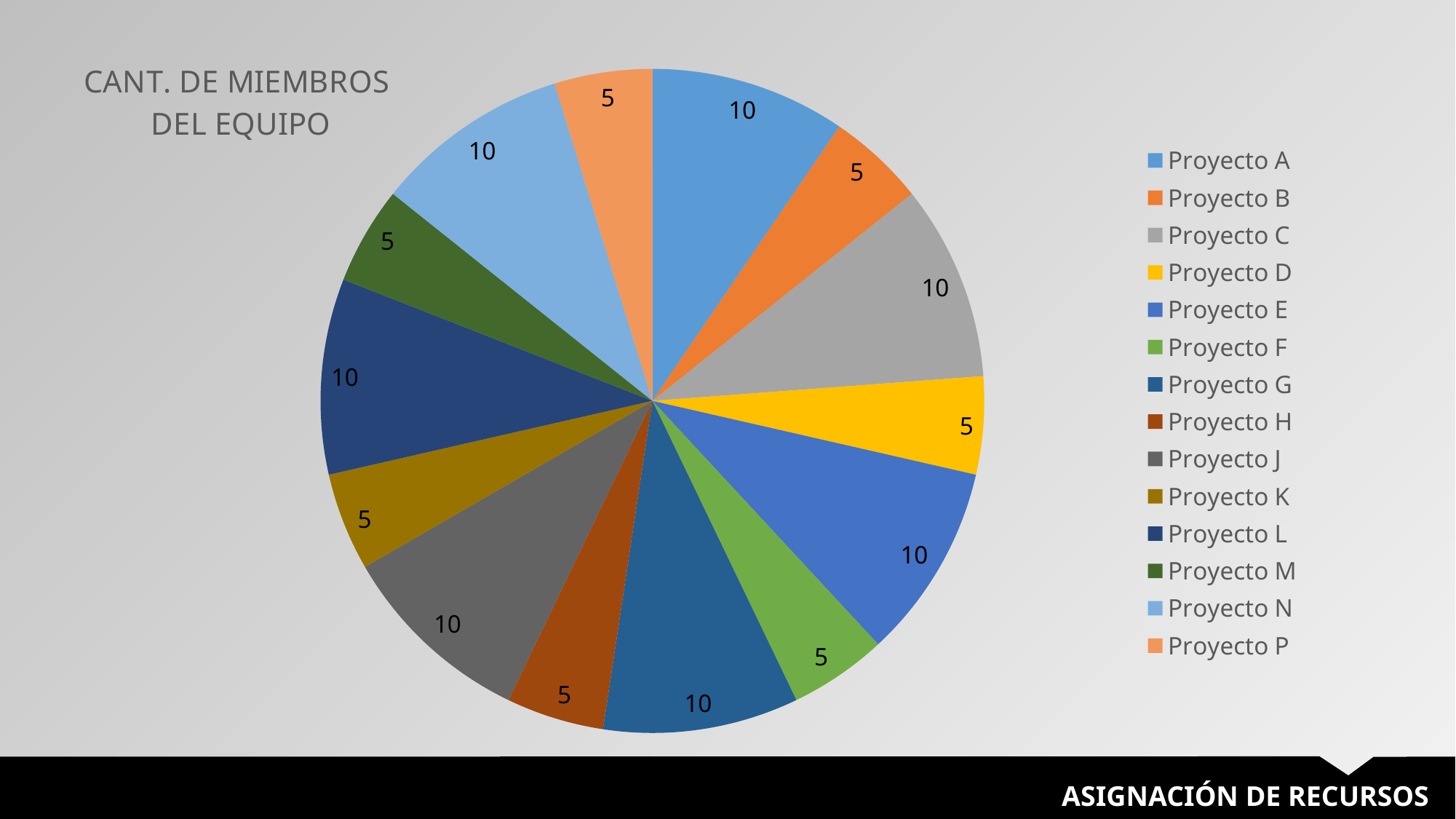
Which is larger, the value for Proyecto E or the value for Proyecto F? Proyecto E What is the value for Proyecto D? 5 What is the last entry listed in the legend? Proyecto P What is the value for Proyecto P? 5 Which is larger, the value for Proyecto K or the value for Proyecto L? Proyecto L What is the value for Proyecto A? 10 What is the value for Proyecto G? 10 How many slices does the pie chart have? 14 What kind of chart is shown on the slide? pie chart What is the title of the chart? CANT. DE MIEMBROS DEL EQUIPO What is the value for Proyecto B? 5 What is the difference between the values for Proyecto C and Proyecto D? 5